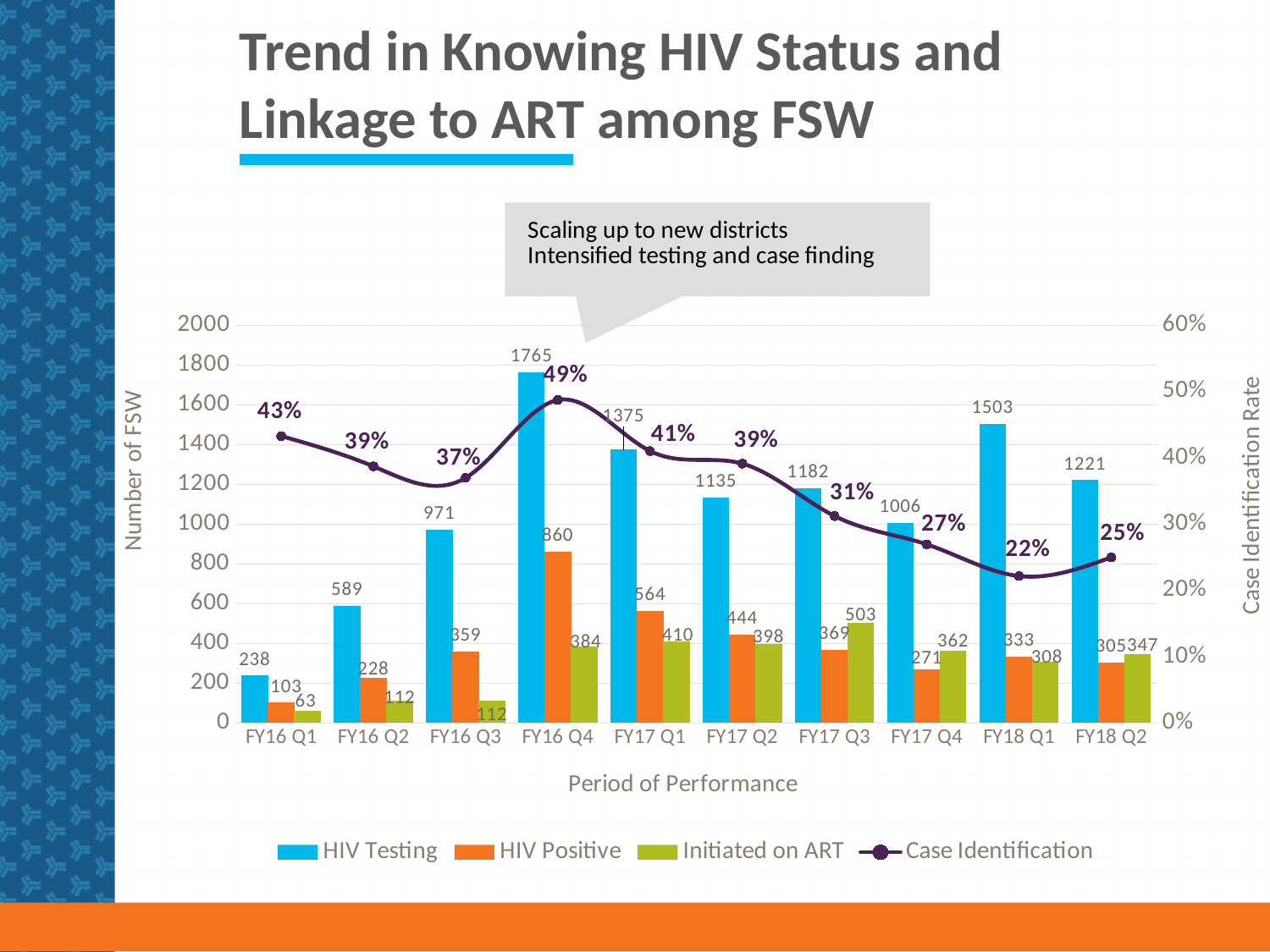
Which period has the larger Initiated on ART value, FY17 Q3 or FY17 Q4? FY17 Q3 How many periods are shown on the x axis? 10 What kind of chart is shown on the slide? Combination bar and line chart How many series does the legend list? 4 What is the title of the x axis? Period of Performance In which period is the HIV Testing value highest? FY16 Q4 What is the difference between the HIV Testing values for FY16 Q4 and FY17 Q1? 390 In which period is the Case Identification rate lowest? FY18 Q1 What is the Case Identification rate for FY18 Q1? 22% What is the HIV Testing value for FY16 Q4? 1765 What is the HIV Positive value for FY16 Q4? 860 Does the Case Identification rate rise or fall from FY17 Q1 to FY18 Q1? Fall